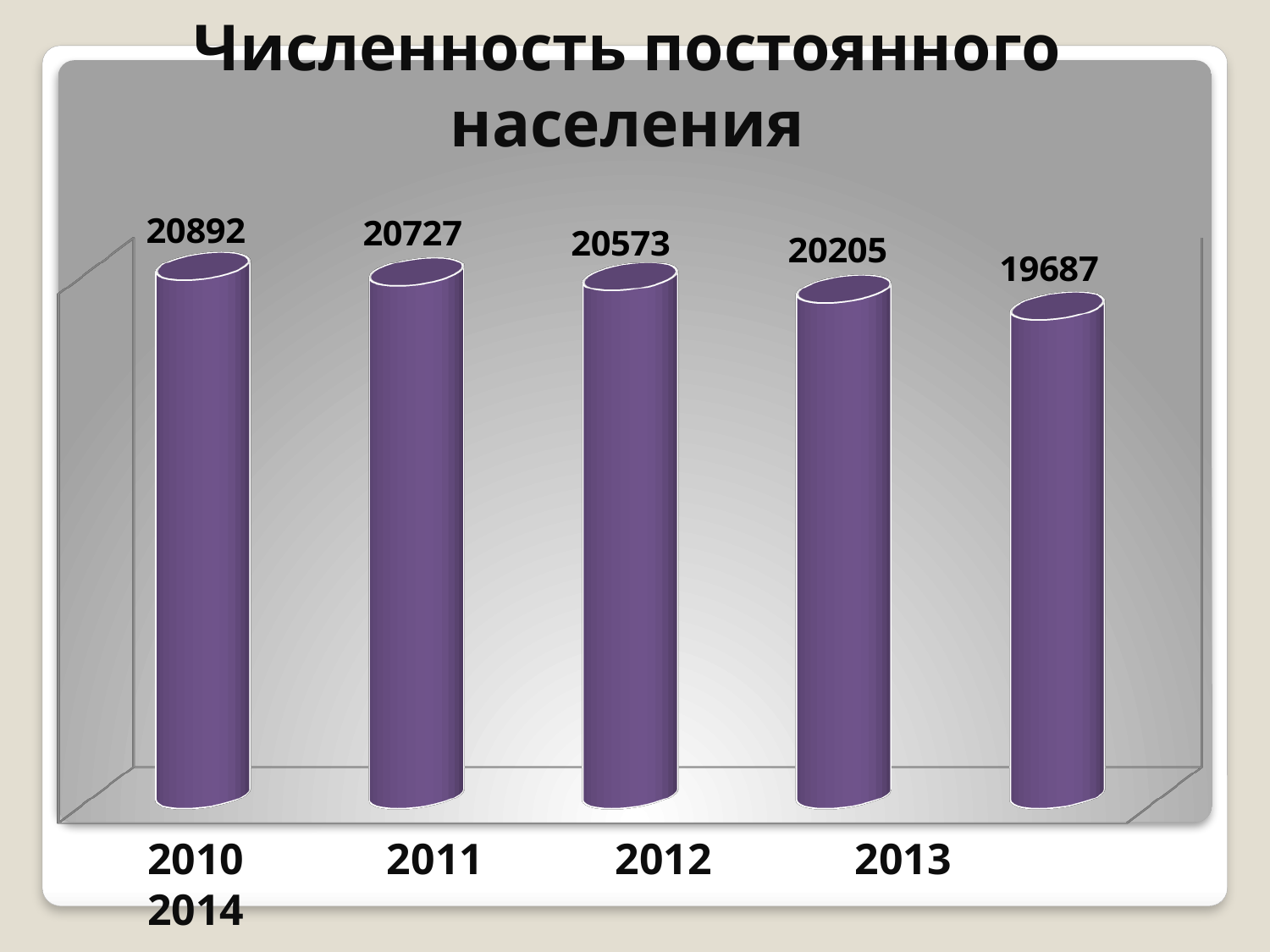
What is the title of the chart? Численность постоянного населения What kind of chart is shown on the slide? Bar chart Which year has the lowest value? 2014 What is the value for 2010? 20892 Do the values rise or fall from 2010 to 2014? Fall What is the difference between the values for 2012 and 2013? 368 What is the difference between the values for 2010 and 2014? 1205 Which is larger, the value for 2011 or the value for 2013? 2011 Which year has the highest value? 2010 What is the value for 2014? 19687 What is the value for 2012? 20573 How many years are shown on the chart? 5